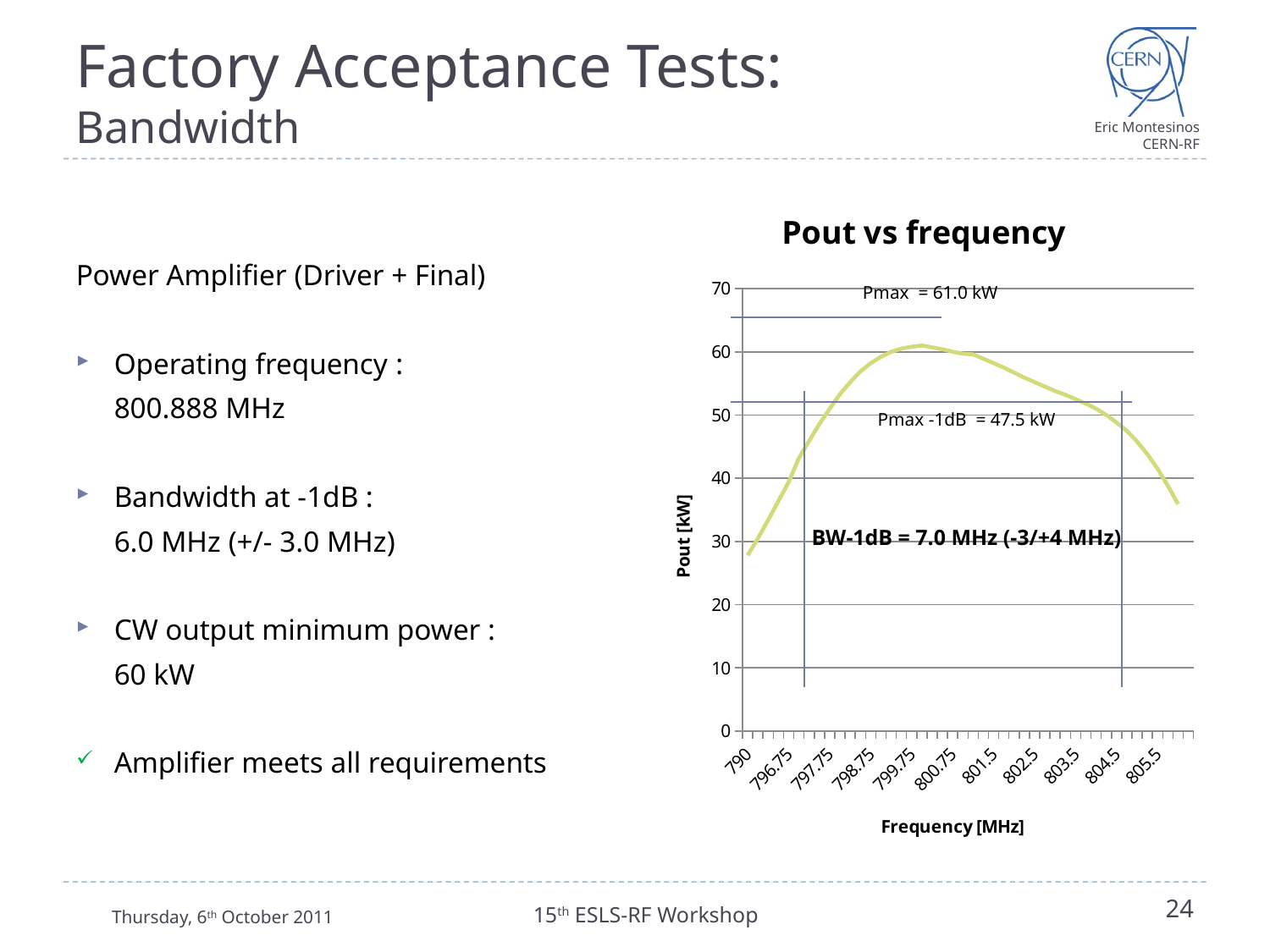
According to the annotation on the chart, what is the value of Pmax -1dB? 47.5 kW What kind of chart is shown on the slide? line chart What is the label of the vertical axis of the chart? Pout [kW] Does the output power rise or fall as frequency increases from 790 MHz to about 799.75 MHz? rise Does the output power rise or fall as frequency increases from about 801.5 MHz to 805.5 MHz? fall What is the highest value shown on the vertical axis of the chart? 70 What is the -1dB bandwidth (BW-1dB) stated on the chart? 7.0 MHz (-3/+4 MHz) Is the peak of the Pout curve greater or less than 60 kW? greater Is the output power at 790 MHz greater or less than 30 kW? less According to the annotation on the chart, what is the value of Pmax? 61.0 kW What is the title of the chart? Pout vs frequency